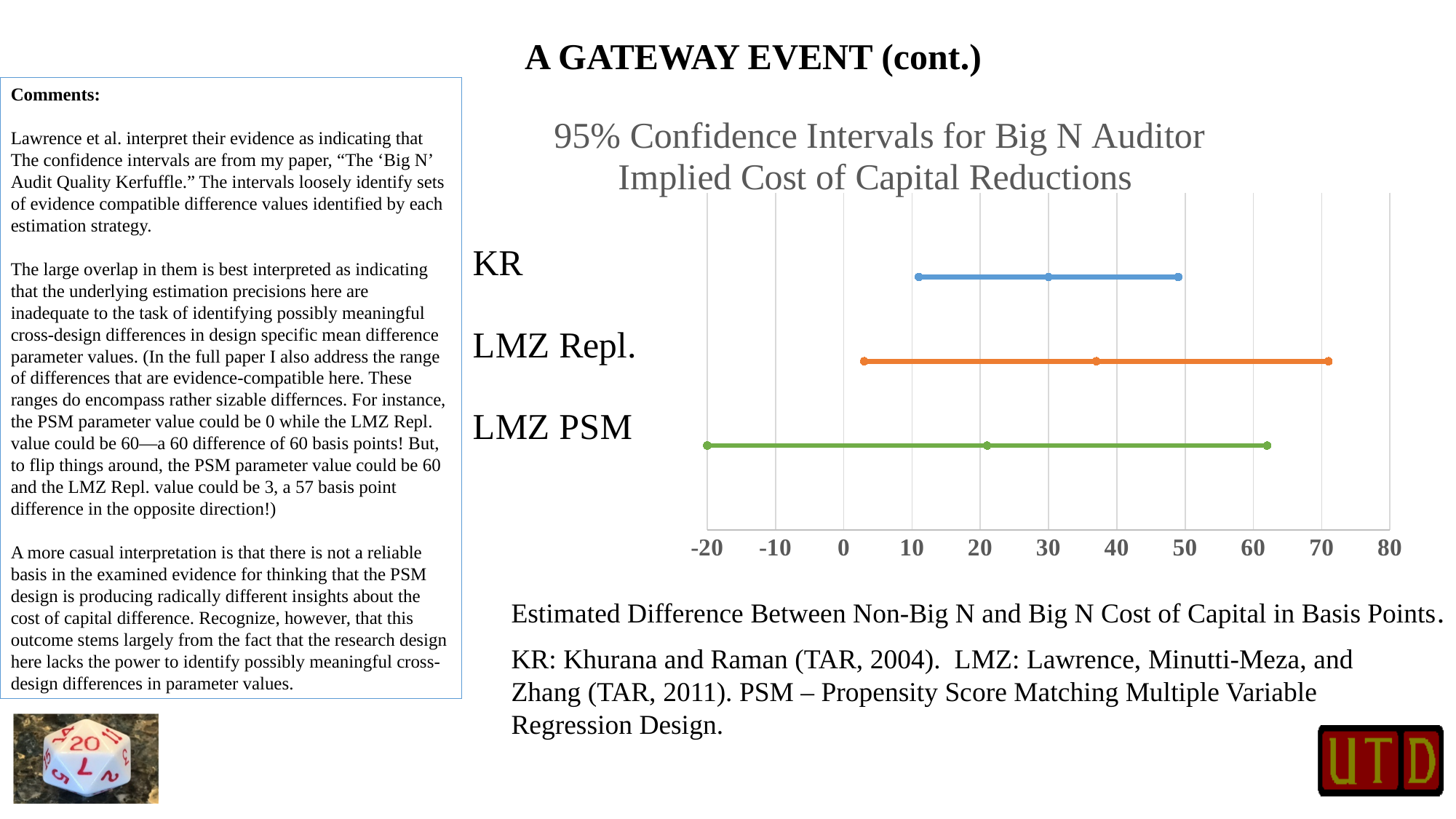
Is the lower endpoint of the KR interval greater or less than 0? greater Which interval extends further to the right, KR or LMZ Repl.? LMZ Repl. What is the title of the chart? 95% Confidence Intervals for Big N Auditor Implied Cost of Capital Reductions Is the upper endpoint of the LMZ Repl. interval greater or less than 60? greater Is the upper endpoint of the LMZ PSM interval greater or less than 50? greater How many confidence intervals (categories) are plotted on the chart? 3 Which category has the widest confidence interval? LMZ PSM Which category has the narrowest confidence interval? KR What colour is the line for the LMZ PSM interval? Green